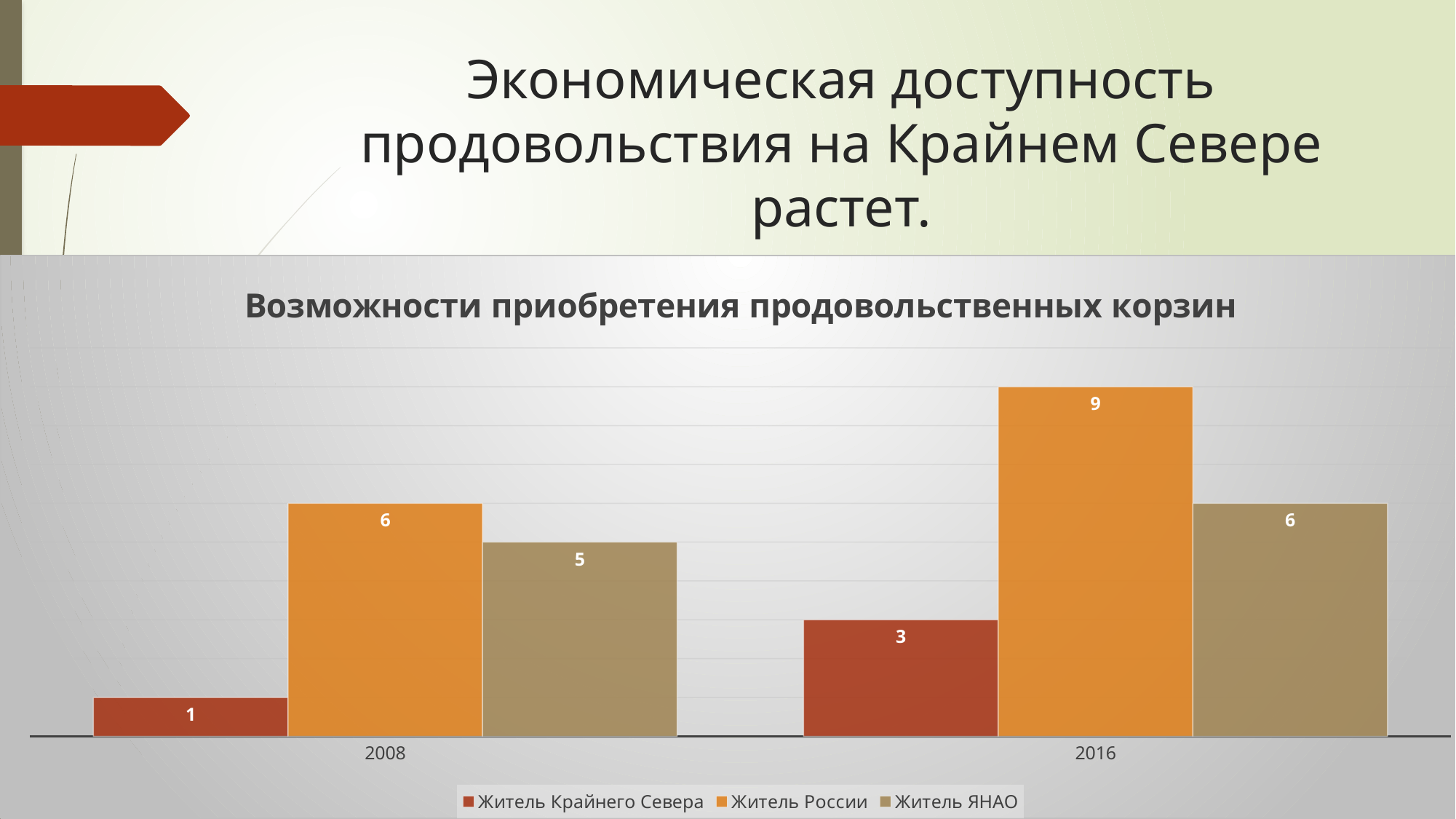
What is the value for Житель России in 2008? 6 How many categories are shown on the x axis? 2 What is the difference between the Житель России values in 2016 and 2008? 3 What kind of chart is shown on the slide? Bar chart How many series does the legend list? 3 Which is larger: Житель ЯНАО in 2016 or Житель Крайнего Севера in 2016? Житель ЯНАО in 2016 What is the value for Житель России in 2016? 9 Does the value for Житель Крайнего Севера rise or fall from 2008 to 2016? Rise What is the value for Житель ЯНАО in 2008? 5 Which series has the highest value in 2016? Житель России What is the value for Житель Крайнего Севера in 2016? 3 Which series has the lowest value in 2008? Житель Крайнего Севера